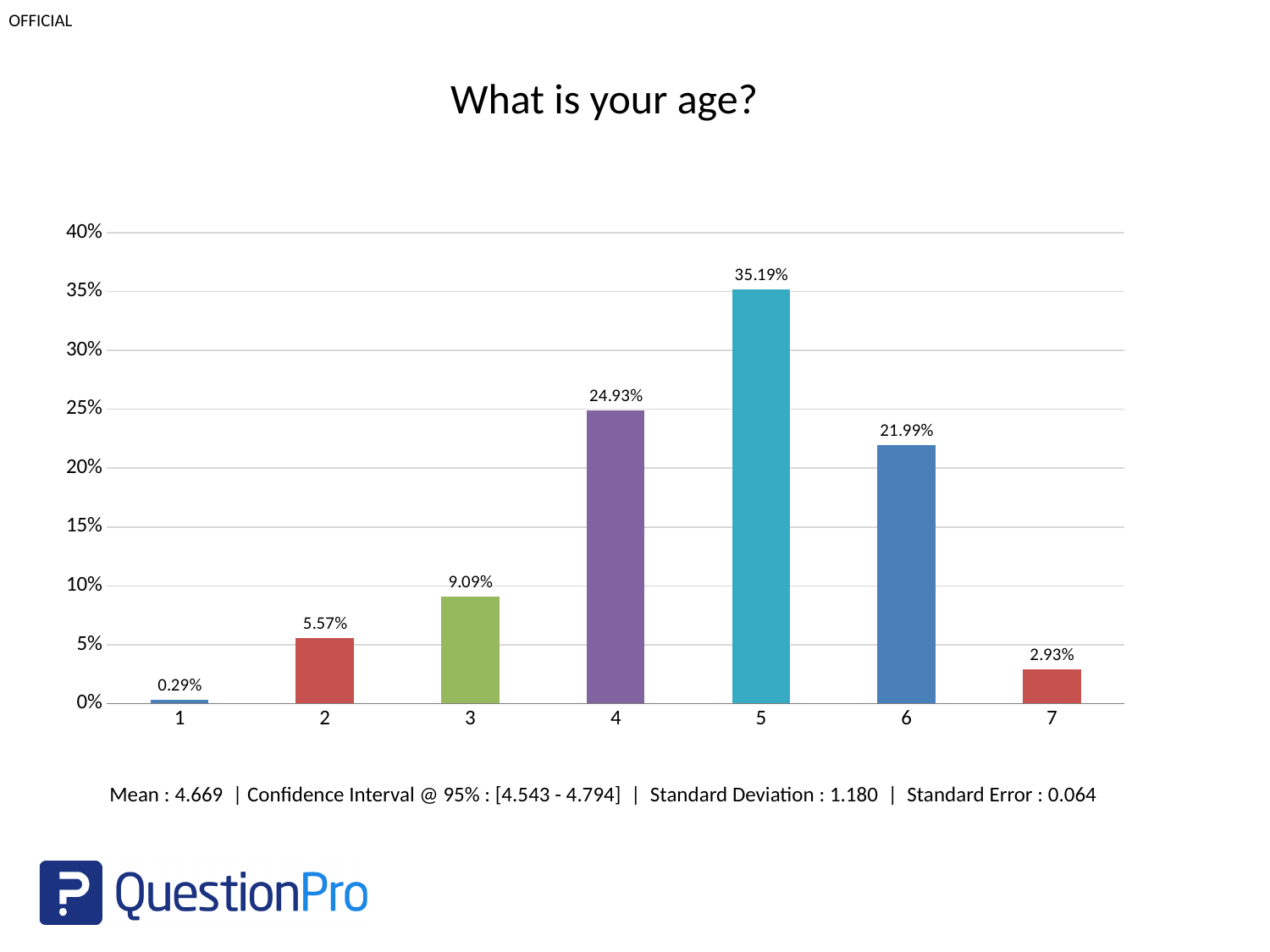
What is the value for category 1? 0.29% What is the title of the chart? What is your age? What is the difference between the values for category 3 and category 2? 3.52% What is the difference between the values for category 5 and category 4? 10.26% How many categories are shown on the x axis? 7 What is the value for category 5? 35.19% What kind of chart is shown on the slide? bar chart Is the value for category 6 greater or less than 20%? greater Which category has the lowest value? 1 Which category has the highest value? 5 What is the value for category 6? 21.99% Which is larger, the value for category 4 or the value for category 6? 4